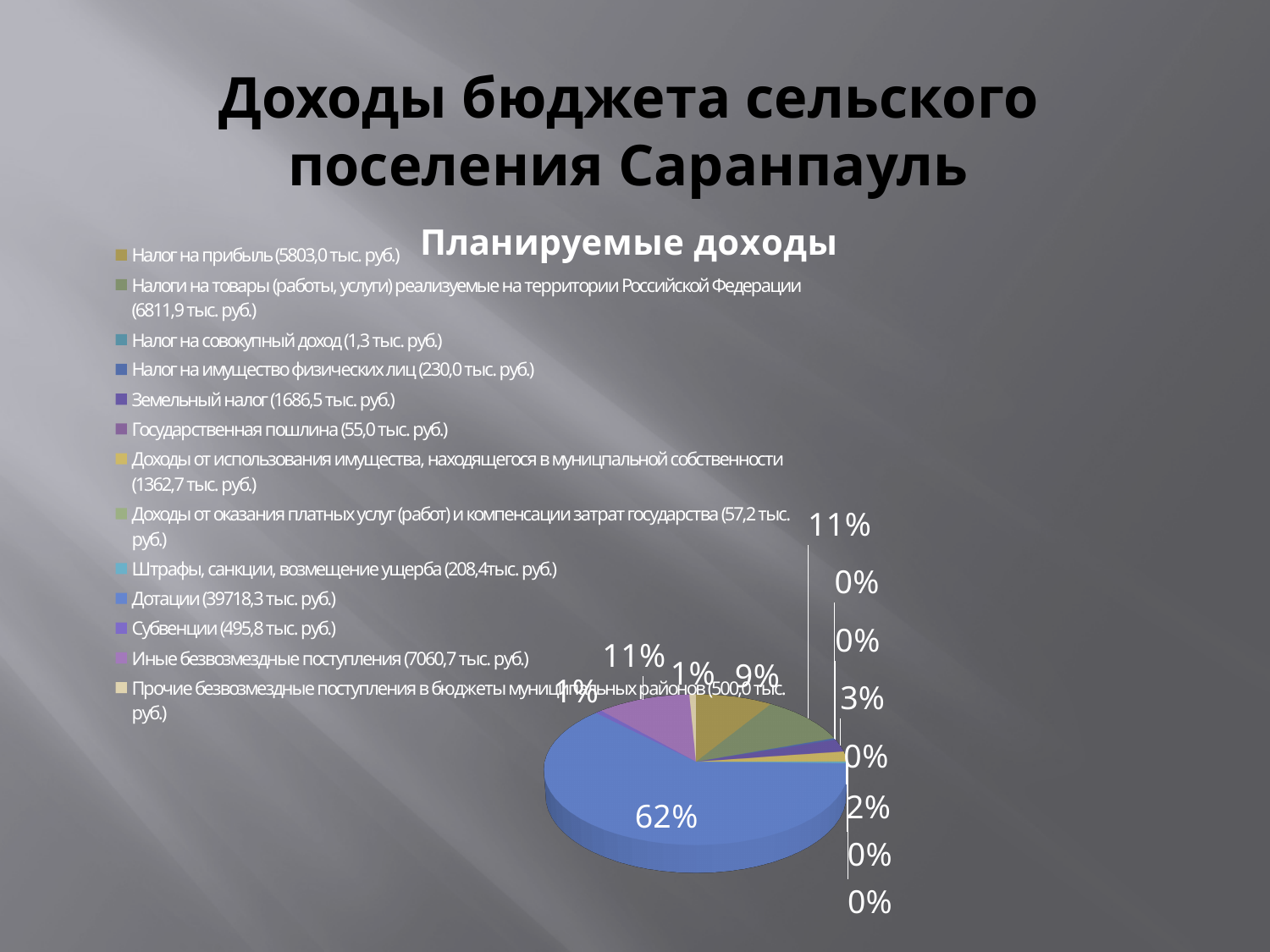
Which is larger: Налоги на товары (работы, услуги) or Налог на прибыль? Налоги на товары (работы, услуги) What is the planned amount for Налог на прибыль according to the legend? 5803,0 тыс. руб. What is the planned amount for Иные безвозмездные поступления according to the legend? 7060,7 тыс. руб. Which category has the largest share of planned income? Дотации (39718,3 тыс. руб.) How many categories does the chart's legend list? 13 What is the title of the chart? Планируемые доходы What is the difference between Дотации (39718,3 тыс. руб.) and Иные безвозмездные поступления (7060,7 тыс. руб.)? 32657,6 тыс. руб. What is the planned amount for Земельный налог according to the legend? 1686,5 тыс. руб. What share of the pie does the largest slice (Дотации) take? 62% What kind of chart is shown on the slide? pie chart What is the difference between Налоги на товары (6811,9 тыс. руб.) and Налог на прибыль (5803,0 тыс. руб.)? 1008,9 тыс. руб. Which category has the smallest planned income according to the legend? Налог на совокупный доход (1,3 тыс. руб.)